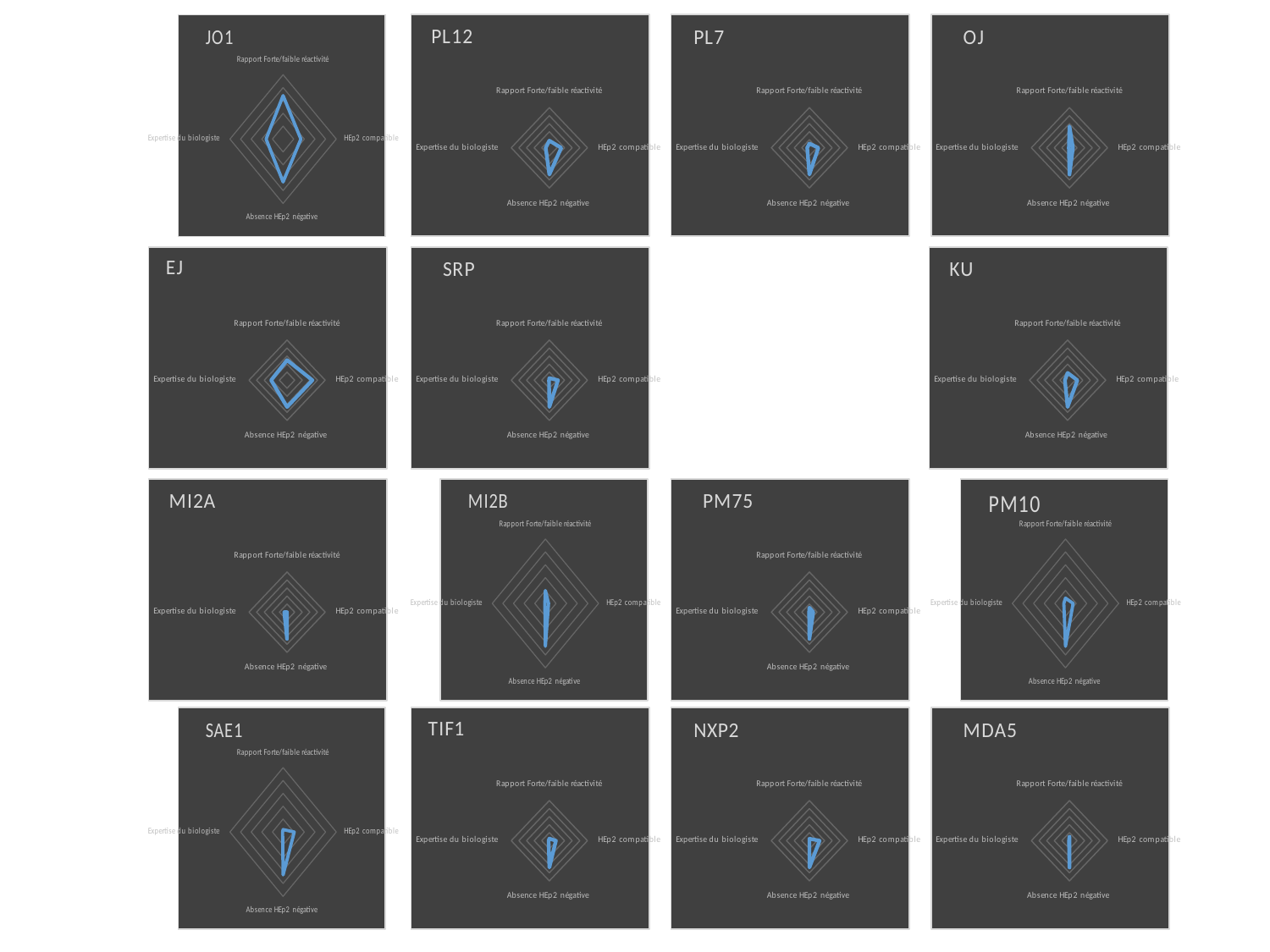
In the EJ chart, which is larger: the value for HEp2 compatible or the value for Rapport Forte/faible réactivité? HEp2 compatible In the JO1 chart, which is larger: the value for Rapport Forte/faible réactivité or the value for Expertise du biologiste? Rapport Forte/faible réactivité How many radar charts are shown on the slide? 15 In the EJ chart, which axis has the lowest value? Expertise du biologiste What kind of chart is the JO1 chart? Radar chart Which axis label appears at the bottom of each radar chart? Absence HEp2 négative What is the title of the chart in the top-left corner of the slide? JO1 In the OJ chart, which is larger: the value for Rapport Forte/faible réactivité or the value for HEp2 compatible? Rapport Forte/faible réactivité How many axes (categories) does the PL12 radar chart have? 4